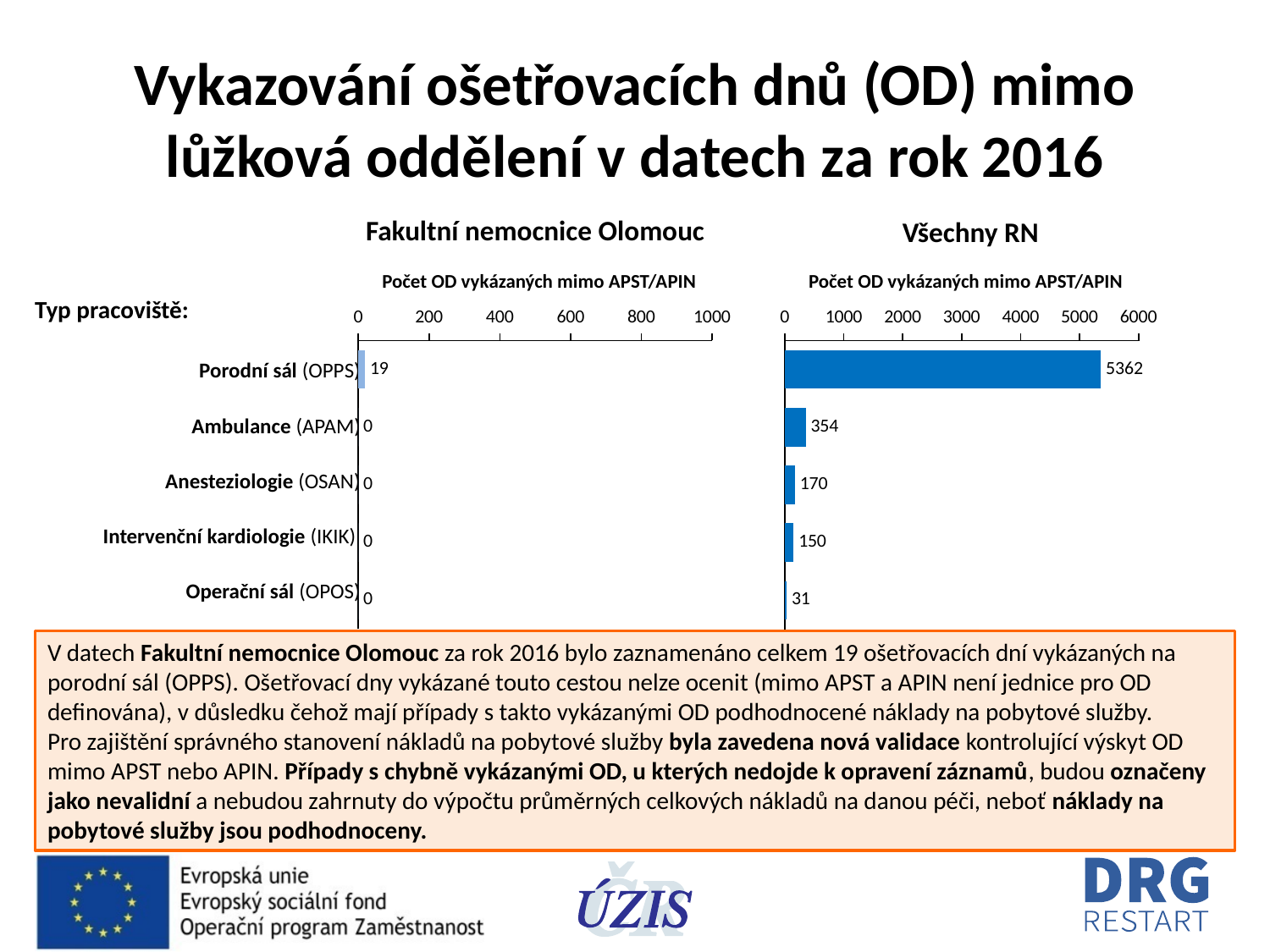
In the 'Všechny RN' chart, what is the difference between the values for Anesteziologie (OSAN) and Intervenční kardiologie (IKIK)? 20 What type of chart is the 'Všechny RN' chart? bar chart In the 'Všechny RN' chart, which is larger: the value for Ambulance (APAM) or the value for Anesteziologie (OSAN)? Ambulance (APAM) In the 'Fakultní nemocnice Olomouc' chart, what is the value for Porodní sál (OPPS)? 19 In the 'Všechny RN' chart, is the value for Porodní sál (OPPS) greater or less than 5000? greater In the 'Všechny RN' chart, which category has the highest value? Porodní sál (OPPS) How many categories are shown in the 'Fakultní nemocnice Olomouc' chart? 5 In the 'Všechny RN' chart, which category has the lowest value? Operační sál (OPOS) In the 'Všechny RN' chart, what is the value for Ambulance (APAM)? 354 What is the axis title shown above the 'Fakultní nemocnice Olomouc' chart? Počet OD vykázaných mimo APST/APIN In the 'Všechny RN' chart, what is the value for Operační sál (OPOS)? 31 In the 'Všechny RN' chart, what is the value for Porodní sál (OPPS)? 5362